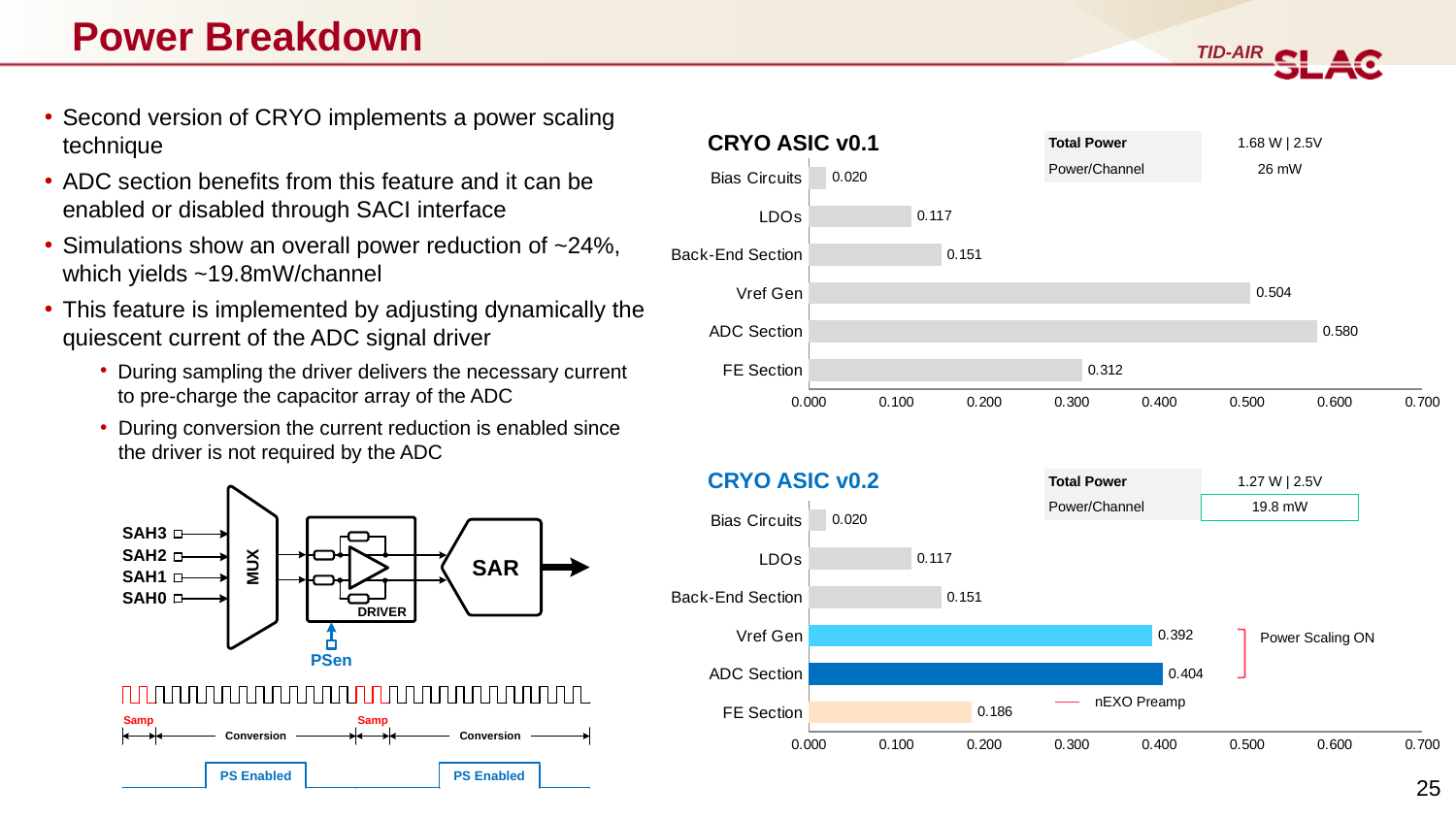
In the CRYO ASIC v0.2 chart, what is the value for the FE Section? 0.186 In the CRYO ASIC v0.2 chart, which category has the lowest value? Bias Circuits How many categories are shown in the CRYO ASIC v0.2 chart? 6 In the CRYO ASIC v0.2 chart, what is the difference between the Vref Gen and FE Section values? 0.206 In the CRYO ASIC v0.1 chart, which category has the highest value? ADC Section In the CRYO ASIC v0.1 chart, which is larger: Vref Gen or FE Section? Vref Gen In the CRYO ASIC v0.2 chart, which two categories are marked with the bracket labelled "Power Scaling ON"? Vref Gen and ADC Section In the CRYO ASIC v0.1 chart, what is the value for the ADC Section? 0.580 In the CRYO ASIC v0.1 chart, is the value for FE Section greater or less than 0.300? greater In the CRYO ASIC v0.2 chart, what is the value for Vref Gen? 0.392 What kind of chart is the CRYO ASIC v0.1 chart? bar chart What is the difference between the ADC Section value in the CRYO ASIC v0.1 chart and the ADC Section value in the CRYO ASIC v0.2 chart? 0.176